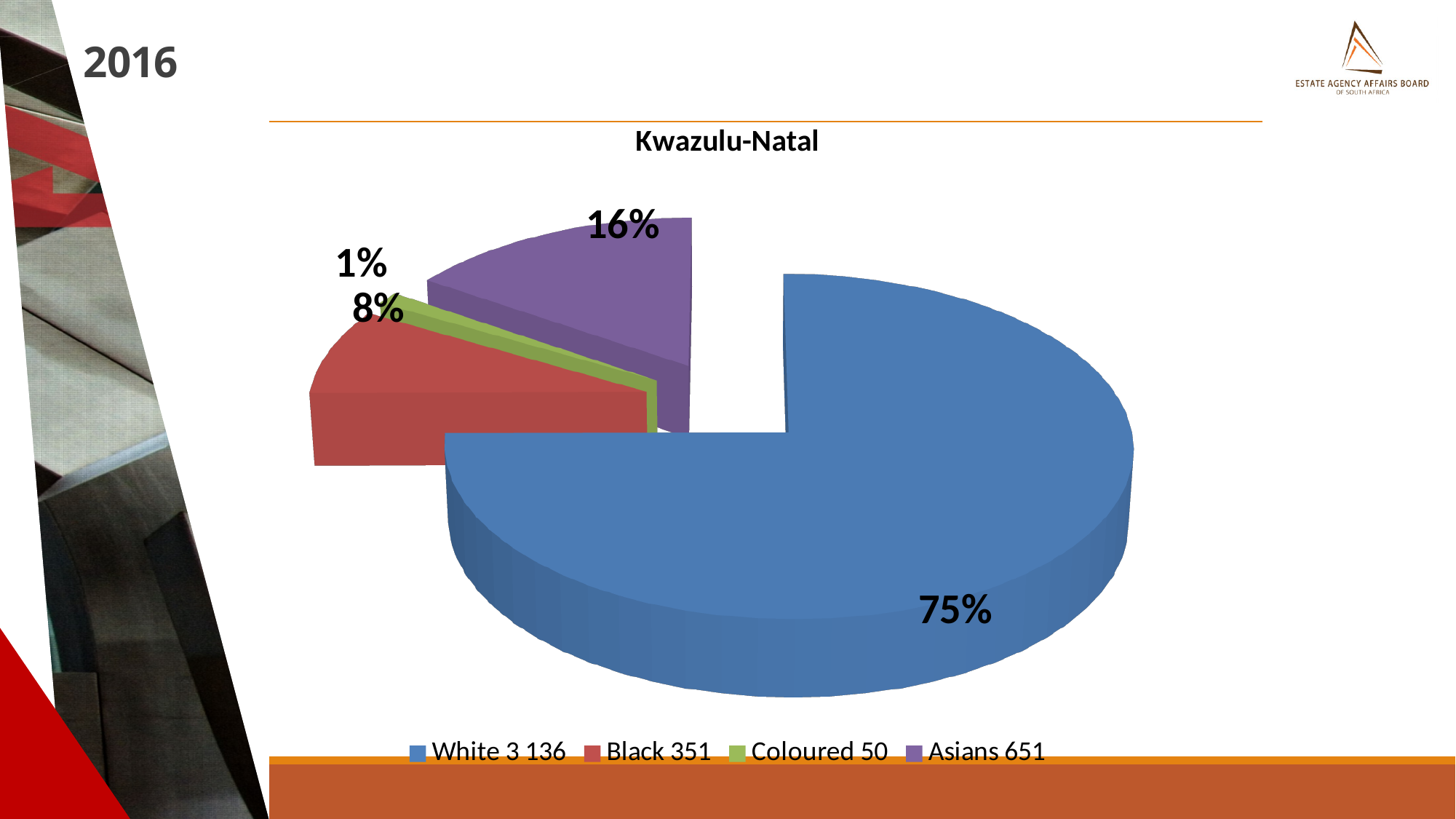
What count is shown next to Asians in the legend? 651 What percentage share does the Coloured slice have? 1% What kind of chart is shown on the slide? pie chart Which category has the smallest slice of the pie? Coloured How many categories does the legend list? 4 What is the title of the chart? Kwazulu-Natal What percentage share does the Black slice have? 8% What percentage share does the Asians slice have? 16% Which slice is larger, Black or Asians? Asians Which category has the largest slice of the pie? White What is the difference in percentage points between the White and Asians slices? 59